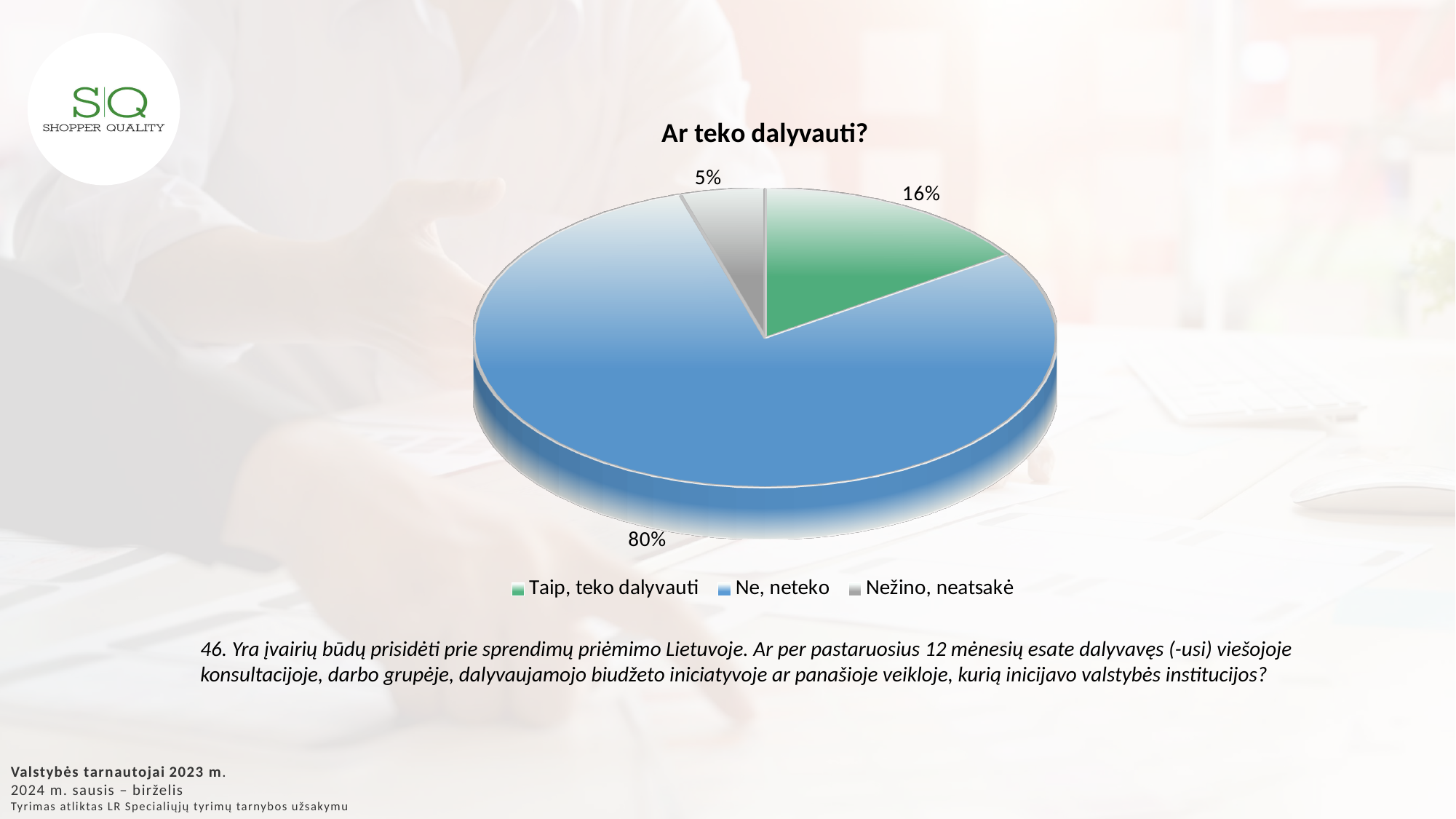
What is the combined share of "Taip, teko dalyvauti" and "Nežino, neatsakė"? 21% How many categories does the pie chart show? 3 What colour is the slice for "Ne, neteko"? Blue What share of the pie is labelled "Taip, teko dalyvauti"? 16% Which is larger: the share for "Taip, teko dalyvauti" or for "Nežino, neatsakė"? Taip, teko dalyvauti What kind of chart is shown on the slide? Pie chart What share of the pie is labelled "Nežino, neatsakė"? 5% What is the difference in percentage points between "Ne, neteko" and "Taip, teko dalyvauti"? 64 Which category has the largest slice of the pie? Ne, neteko Which category has the smallest slice of the pie? Nežino, neatsakė What share of the pie is labelled "Ne, neteko"? 80% What is the title of the chart? Ar teko dalyvauti?